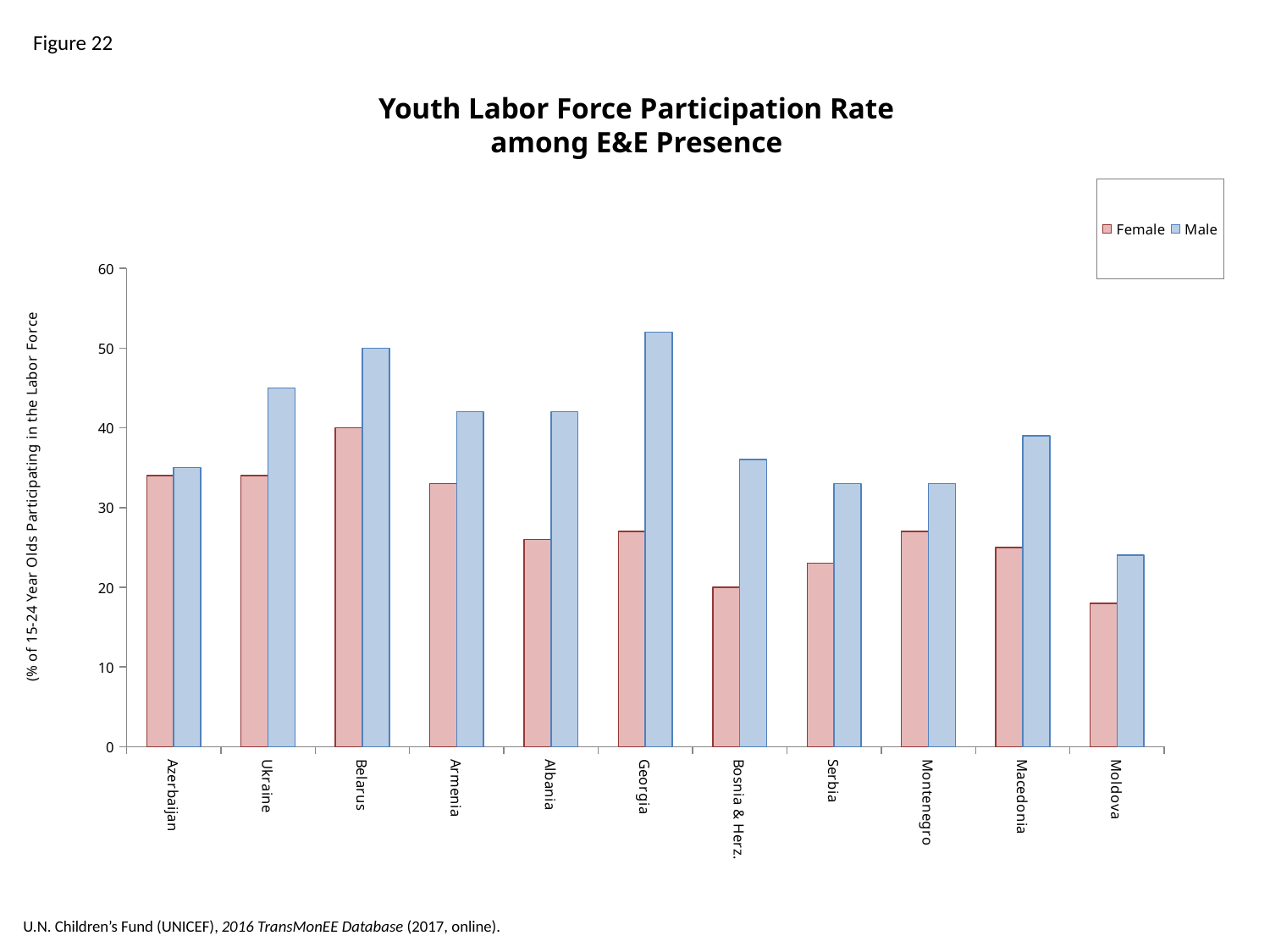
What kind of chart is shown on the slide? bar chart Is the Male value for Ukraine greater or less than 40? greater How many countries are shown on the x axis? 11 Is the Female value for Bosnia & Herz. greater or less than 30? less What are the two series named in the legend? Female and Male Which country has the lowest Male value? Moldova Is the Male value for Macedonia greater or less than 30? greater What is the Female value for Belarus? 40 Which country has the highest Female value? Belarus Which is larger, the Male value for Ukraine or the Male value for Armenia? Ukraine What is the Male value for Belarus? 50 How many series does the legend list? 2